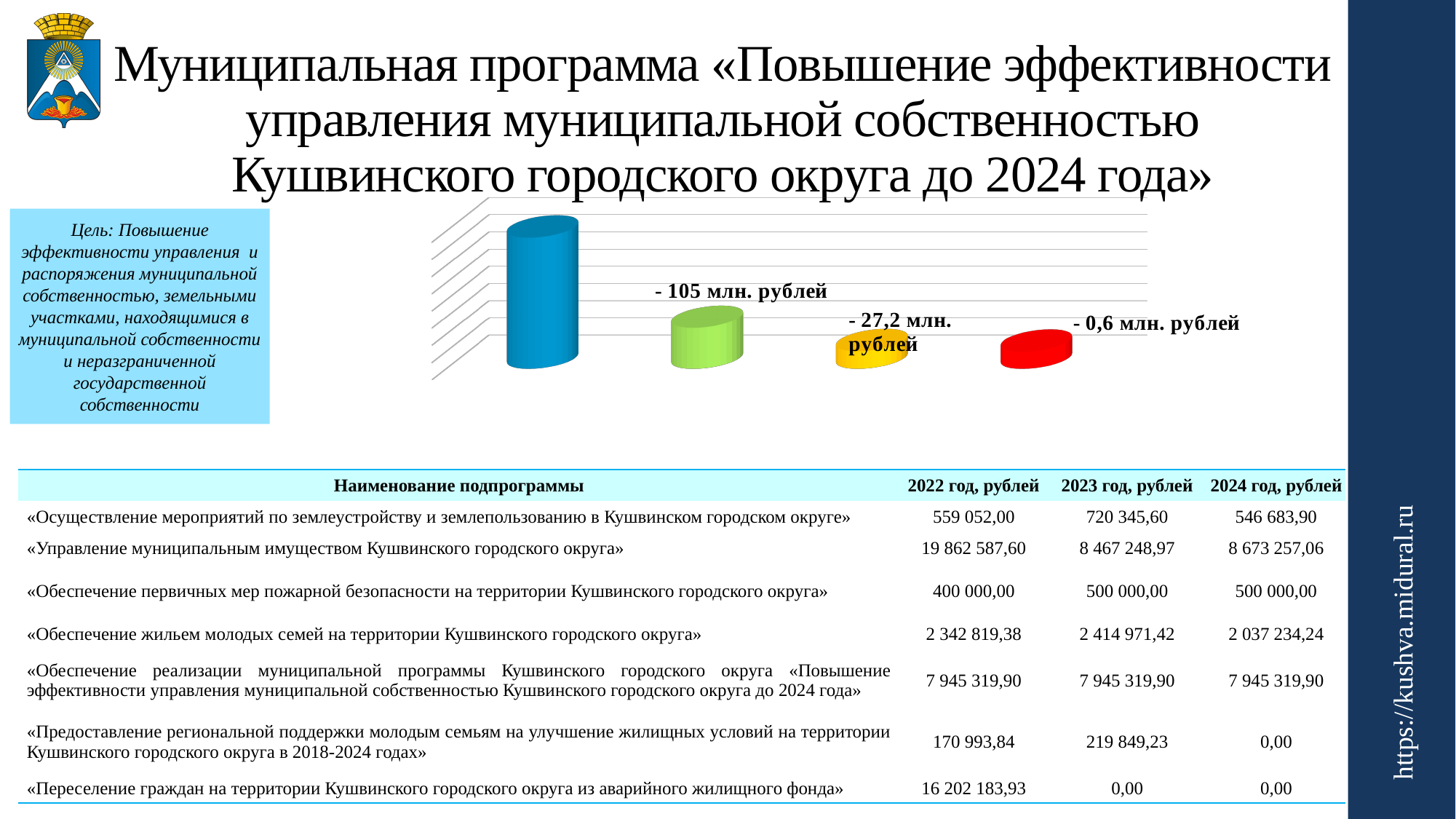
Which bar in the chart is the shortest? the red bar What colour is the bar that has no value label in the chart? blue What value is labelled for the green bar? - 105 млн. рублей What is the difference between the labelled values of the green bar and the yellow bar? 77,8 млн. рублей Do the bar heights rise or fall from left to right across the chart? fall What is the difference between the labelled values of the yellow bar and the red bar? 26,6 млн. рублей How many bars does the chart contain? 4 Which bar in the chart is the tallest? the blue bar What kind of chart is shown at the top of the slide? bar chart Which is larger, the value of the green bar or the value of the yellow bar? the green bar What value is labelled for the red bar? - 0,6 млн. рублей What value is labelled for the yellow bar? - 27,2 млн. рублей